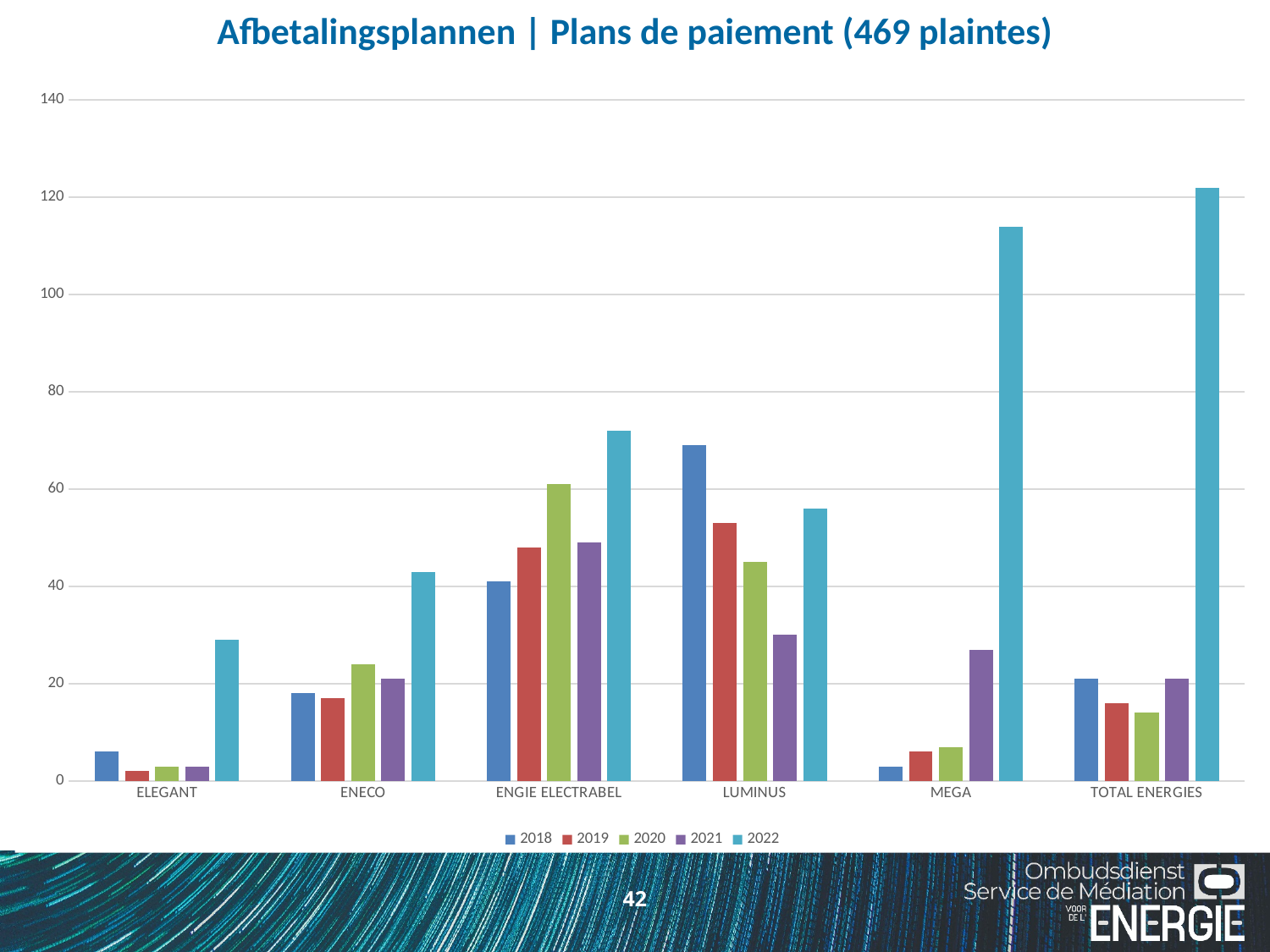
How many supplier categories are shown on the x axis? 6 How many series does the legend list? 5 Is the 2022 value for MEGA greater or less than 100? greater Do the values for MEGA rise or fall from 2018 to 2022? rise Which supplier has the lowest 2022 bar? ELEGANT Which supplier has the highest 2018 bar? LUMINUS Is the 2022 value for ELEGANT greater or less than 40? less What is the title of the chart? Afbetalingsplannen | Plans de paiement (469 plaintes) What kind of chart is shown on the slide? bar chart Which supplier has the highest 2022 bar? TOTAL ENERGIES Which is larger: the 2020 value for ENGIE ELECTRABEL or the 2020 value for LUMINUS? ENGIE ELECTRABEL Is the 2022 value for ENGIE ELECTRABEL greater or less than 60? greater